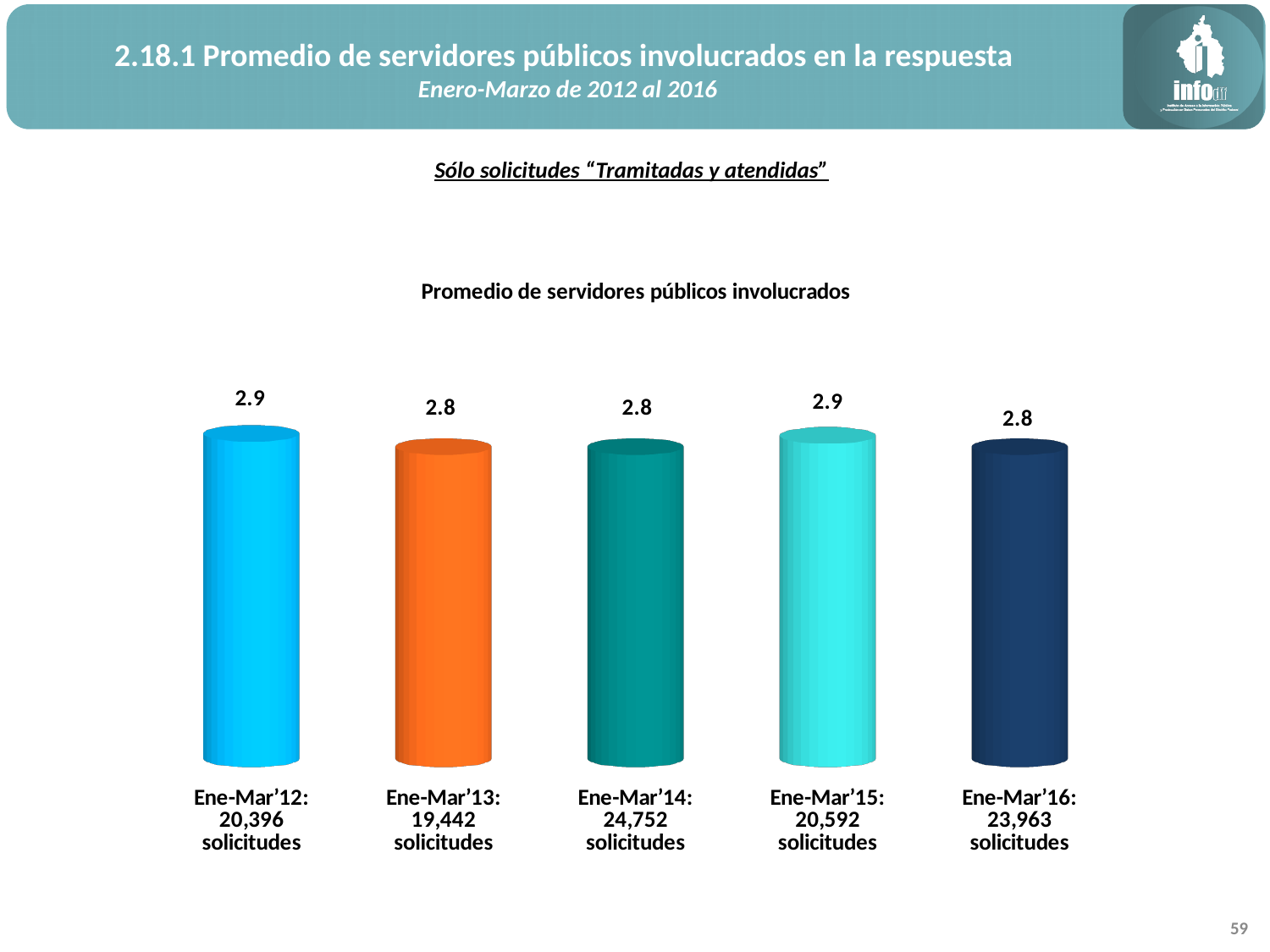
What is the average number of public servants involved for Ene-Mar'13? 2.8 Which is larger, the value for Ene-Mar'15 or the value for Ene-Mar'16? Ene-Mar'15 What is the difference between the values for Ene-Mar'12 and Ene-Mar'13? 0.1 How many solicitudes are listed under the Ene-Mar'14 label? 24,752 What is the value shown for Ene-Mar'15? 2.9 What is the title of the chart? Promedio de servidores públicos involucrados How many periods (bars) are shown in the chart? 5 What colour is the bar for Ene-Mar'13? Orange What kind of chart is shown on the slide? Bar chart What is the average number of public servants involved for Ene-Mar'12? 2.9 How many solicitudes are listed under the Ene-Mar'13 label? 19,442 What is the average number of public servants involved for Ene-Mar'16? 2.8